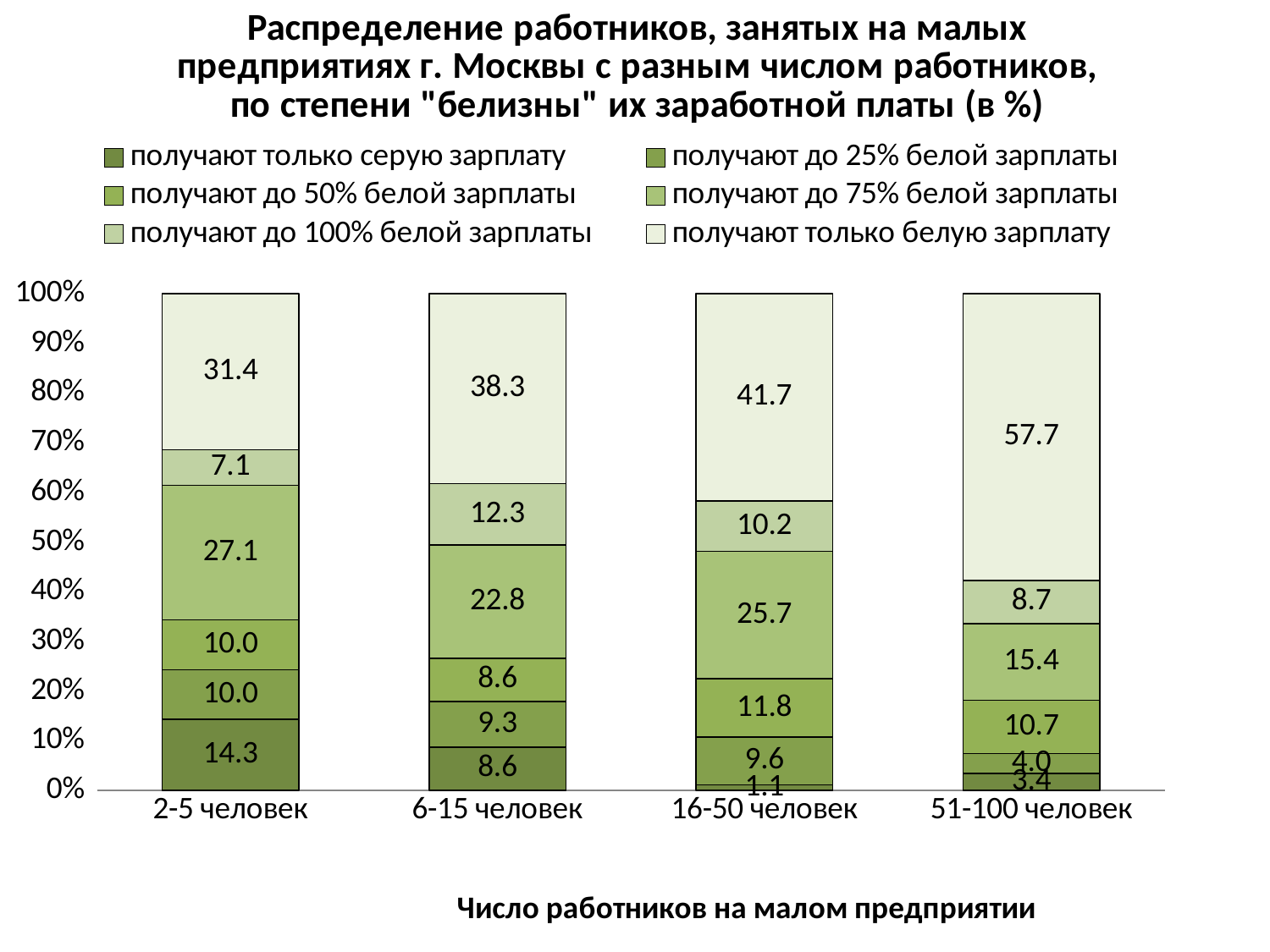
Which category has the lowest share of workers receiving only a grey salary (получают только серую зарплату)? 16-50 человек What share of workers at enterprises with 2-5 people receive only a white salary (получают только белую зарплату)? 31.4 What kind of chart is shown on the slide? Stacked bar chart Which is larger: the 'получают до 75% белой зарплаты' value for 2-5 человек or for 51-100 человек? 2-5 человек What is the difference between the 'получают только белую зарплату' values for 51-100 человек and 2-5 человек? 26.3 What is the value for 'получают до 100% белой зарплаты' in the 6-15 человек category? 12.3 Does the share of workers receiving only a white salary rise or fall as the enterprise size increases along the x axis? Rises How many categories are shown on the x axis? 4 What is the x-axis title of the chart? Число работников на малом предприятии How many series does the legend list? 6 Which category has the highest share of workers receiving only a white salary (получают только белую зарплату)? 51-100 человек What is the value for 'получают до 50% белой зарплаты' in the 16-50 человек category? 11.8